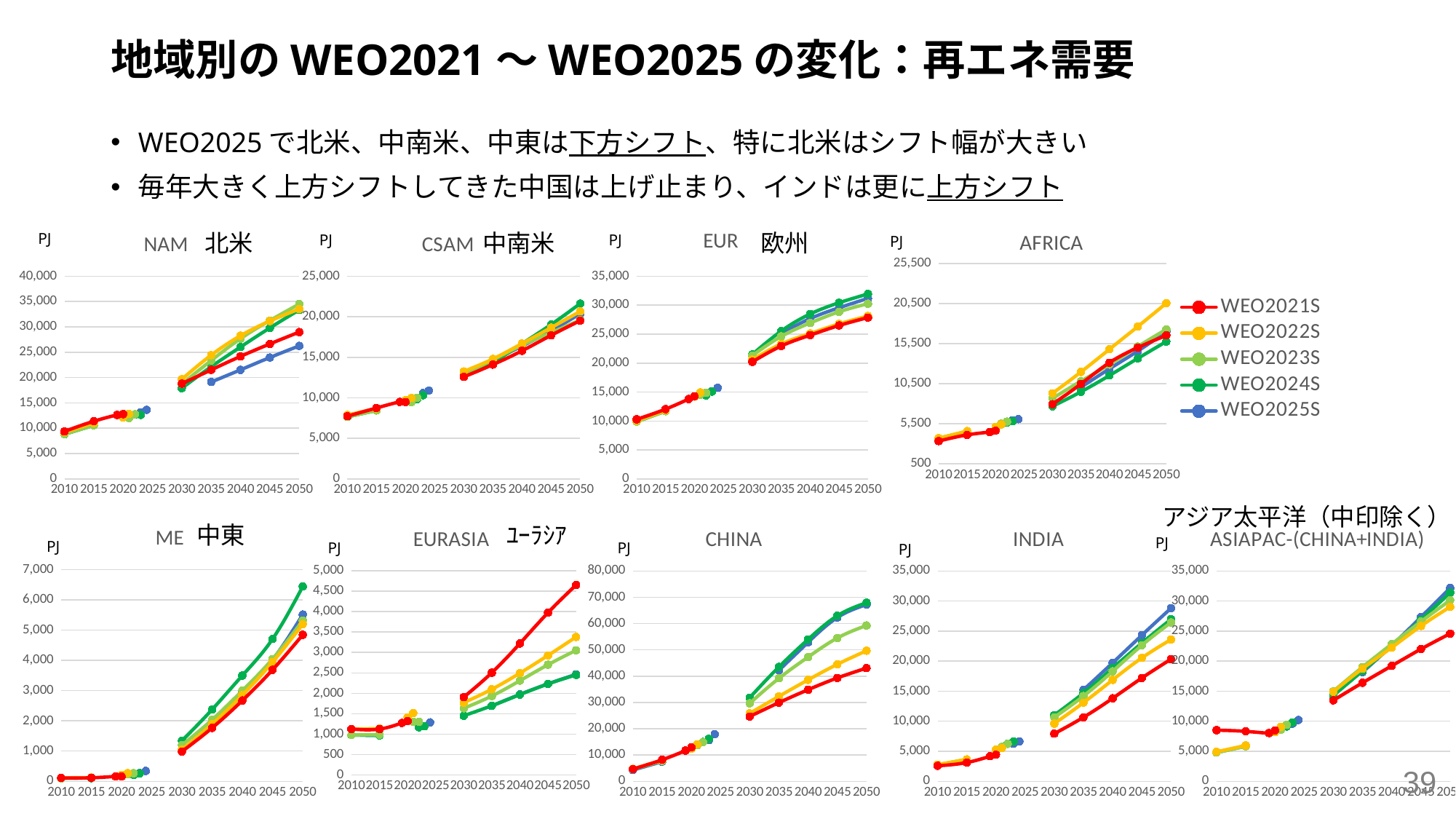
In the NAM chart, which series has the lowest value in 2050? WEO2025S How many series does the legend list? 5 In the INDIA chart, which is larger in 2050, WEO2025S or WEO2021S? WEO2025S In the EURASIA chart, is the WEO2024S value in 2050 greater or less than 3,000? less In the CHINA chart, is the WEO2024S value in 2050 greater or less than 60,000? greater In the EURASIA chart, which series has the highest value in 2050? WEO2021S In the EUR chart, is the WEO2021S value in 2050 greater or less than 30,000? less What kind of chart is the NAM chart? line chart How many charts are shown on the slide? 9 In the CSAM chart, do the WEO2024S values rise or fall from 2030 to 2050? rise In the CHINA chart, which series has the lowest value in 2050? WEO2021S In the ME chart, which series has the highest value in 2050? WEO2024S